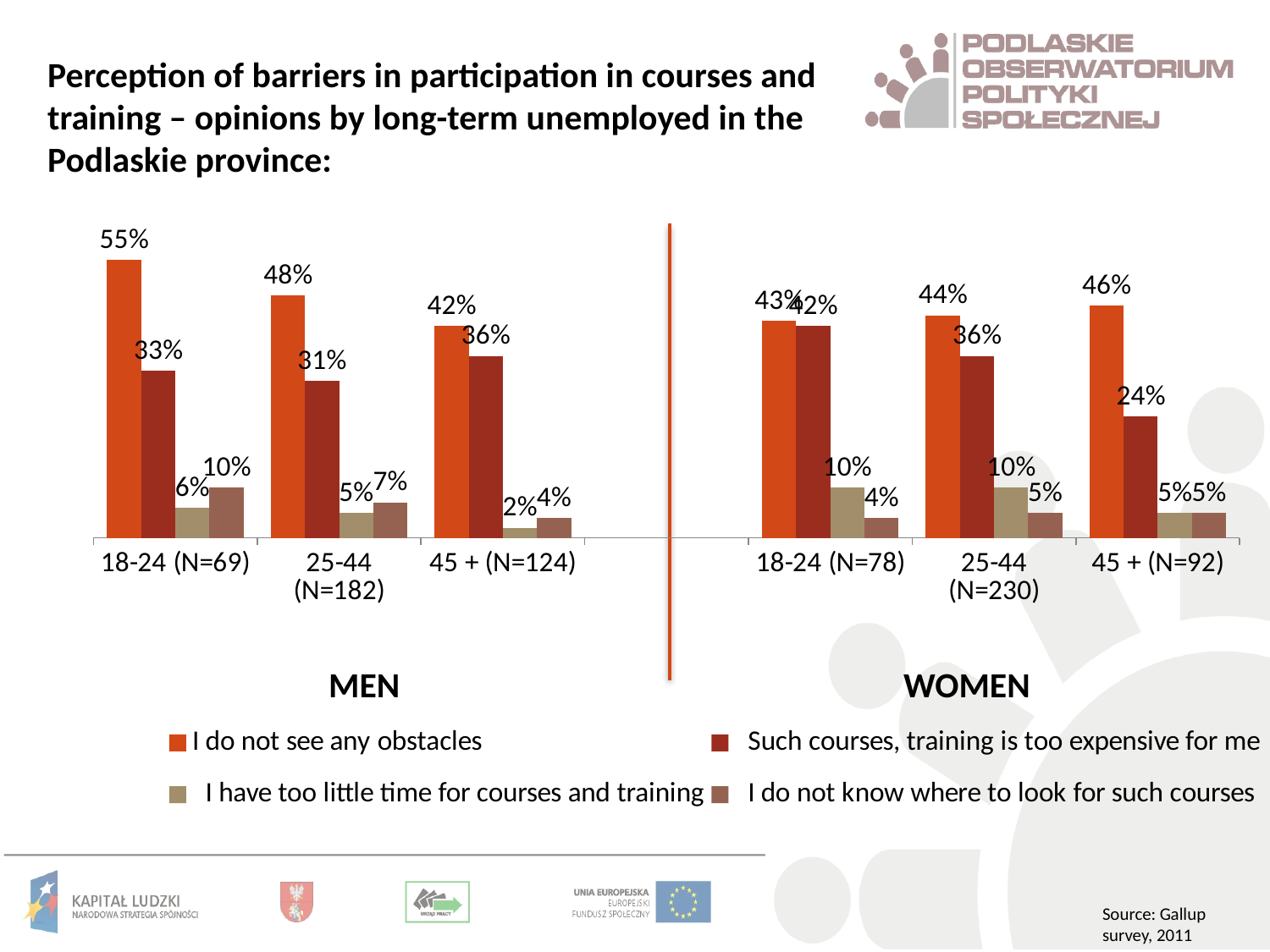
In the MEN chart, what is the difference between the 'I do not see any obstacles' values for the 18-24 (N=69) and 45 + (N=124) groups? 13 percentage points In the WOMEN chart, which is larger for the 18-24 (N=78) group: 'I have too little time for courses and training' or 'I do not know where to look for such courses'? I have too little time for courses and training In the WOMEN chart, what percentage of the 45 + (N=92) group said 'Such courses, training is too expensive for me'? 24% In the WOMEN chart, what percentage of the 25-44 (N=230) group said 'I do not know where to look for such courses'? 5% In the MEN chart, what percentage of the 45 + (N=124) group said 'I have too little time for courses and training'? 2% How many series does the legend list? 4 How many age groups are shown in the WOMEN chart? 3 In the MEN chart, which age group has the highest value for 'I do not see any obstacles'? 18-24 (N=69) In the WOMEN chart, which age group has the lowest value for 'Such courses, training is too expensive for me'? 45 + (N=92) In the MEN chart, what percentage of the 18-24 (N=69) group said 'I do not see any obstacles'? 55% In the WOMEN chart, does the value for 'I do not see any obstacles' rise or fall from the 18-24 group to the 45 + group? Rise What kind of chart is used for the MEN data? Bar chart